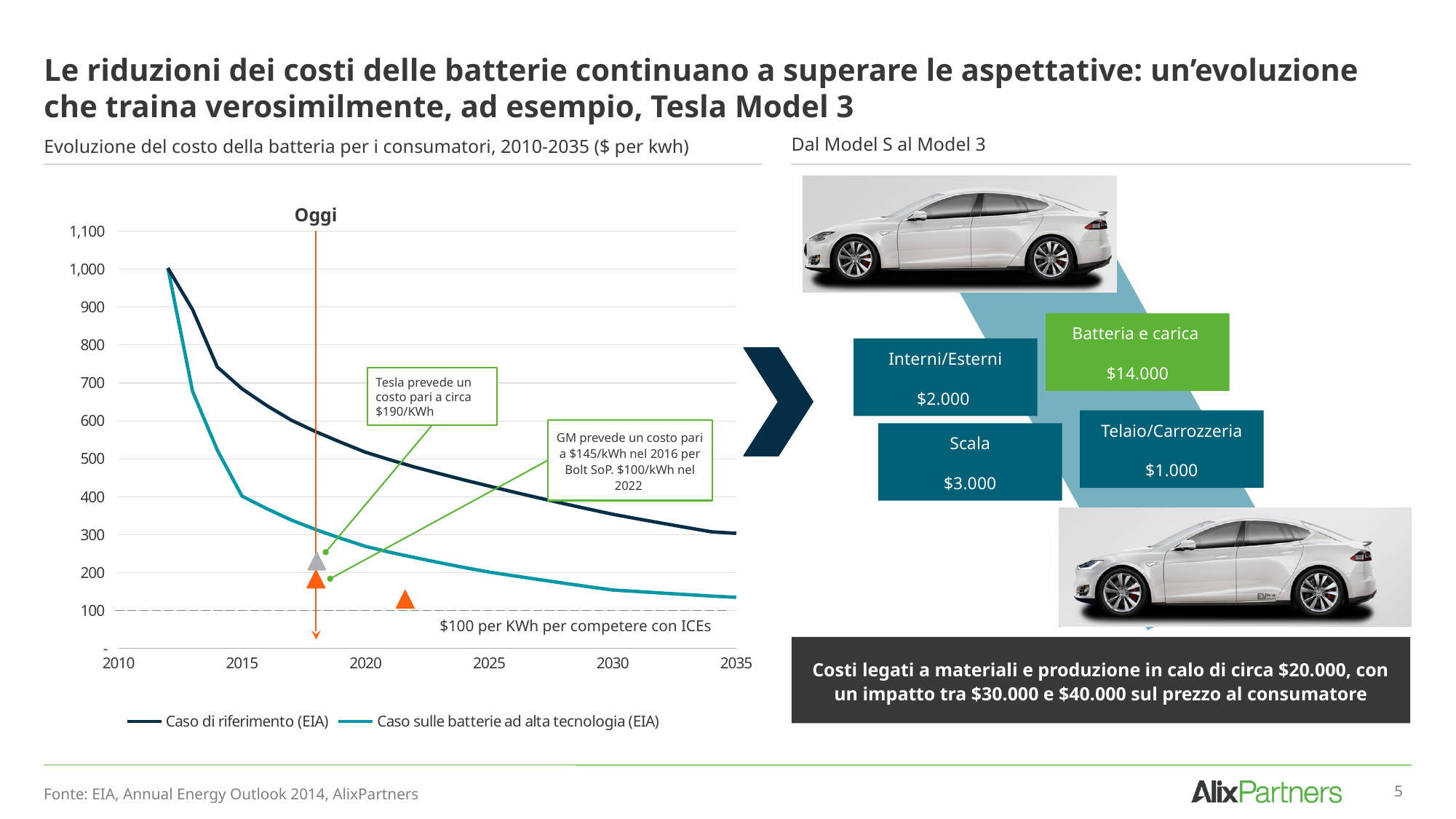
Is the value of the Caso sulle batterie ad alta tecnologia (EIA) line in 2035 greater or less than 200? less Is the value of the Caso sulle batterie ad alta tecnologia (EIA) line in 2035 greater or less than 100? greater According to the annotation on the chart, what battery cost does GM expect in 2022? $100/kWh Do the values of the Caso di riferimento (EIA) line rise or fall from 2012 to 2035? fall Is the value of the Caso di riferimento (EIA) line in 2035 greater or less than 400? less What are the two series named in the chart legend? Caso di riferimento (EIA) and Caso sulle batterie ad alta tecnologia (EIA) How many series does the chart legend list? 2 In 2025, which line is higher: Caso di riferimento (EIA) or Caso sulle batterie ad alta tecnologia (EIA)? Caso di riferimento (EIA) What kind of chart is shown on the slide? line chart According to the annotation on the chart, what battery cost does Tesla expect? circa $190/KWh